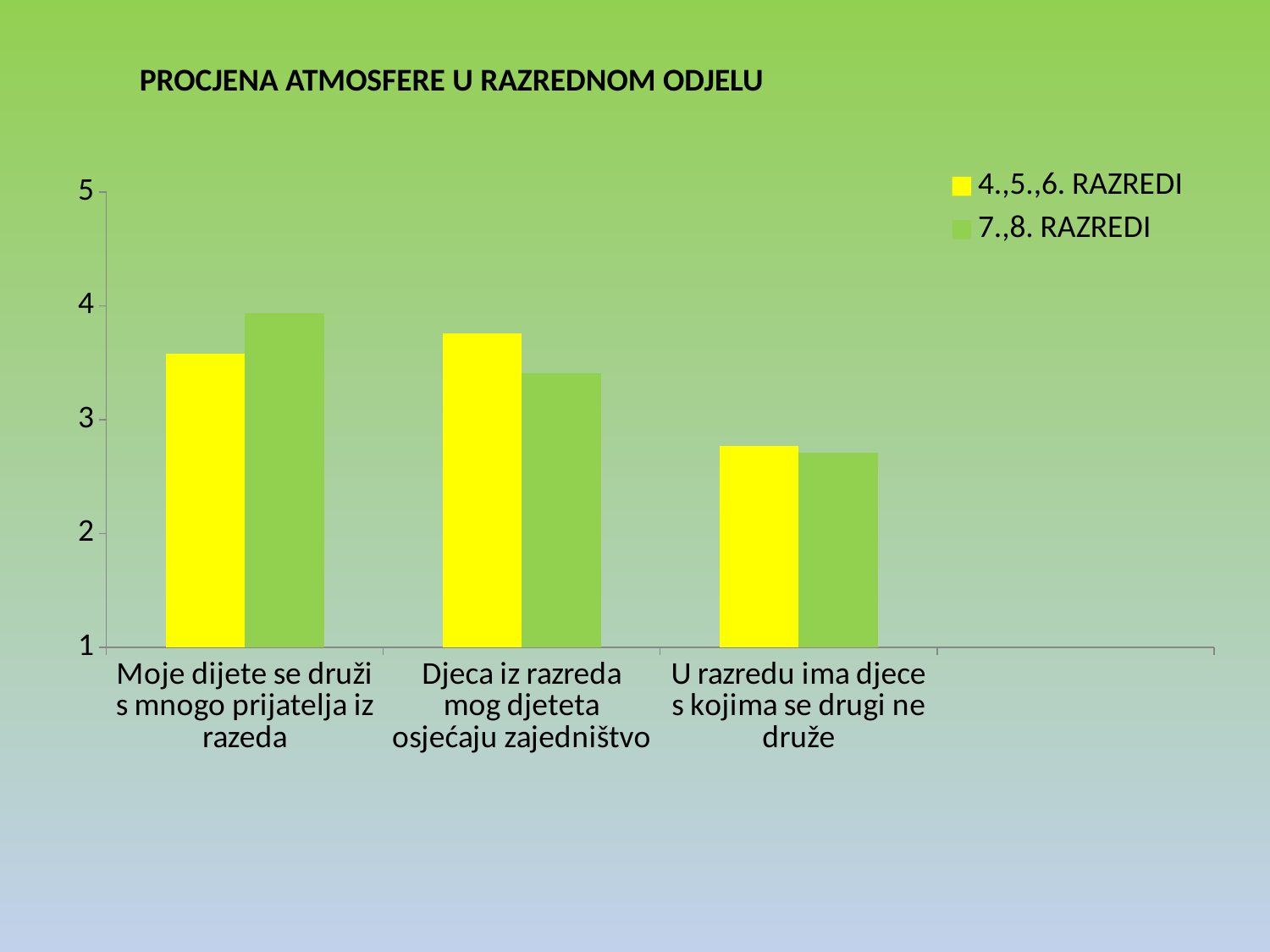
How many categories are shown on the x axis? 3 Is the value for 7.,8. RAZREDI in the category 'Moje dijete se druži s mnogo prijatelja iz razeda' greater or less than 4? less Is the value for 4.,5.,6. RAZREDI in the category 'U razredu ima djece s kojima se drugi ne druže' greater or less than 3? less What kind of chart is shown on the slide? bar chart In the category 'Djeca iz razreda mog djeteta osjećaju zajedništvo', which series has the larger value, 4.,5.,6. RAZREDI or 7.,8. RAZREDI? 4.,5.,6. RAZREDI What is the title of the chart? PROCJENA ATMOSFERE U RAZREDNOM ODJELU How many series does the legend list? 2 For the 7.,8. RAZREDI series, which category has the highest value? Moje dijete se druži s mnogo prijatelja iz razeda Which colour represents the 7.,8. RAZREDI series? green Is the value for 4.,5.,6. RAZREDI in the category 'Moje dijete se druži s mnogo prijatelja iz razeda' greater or less than 3? greater In the category 'Moje dijete se druži s mnogo prijatelja iz razeda', which series has the larger value, 4.,5.,6. RAZREDI or 7.,8. RAZREDI? 7.,8. RAZREDI